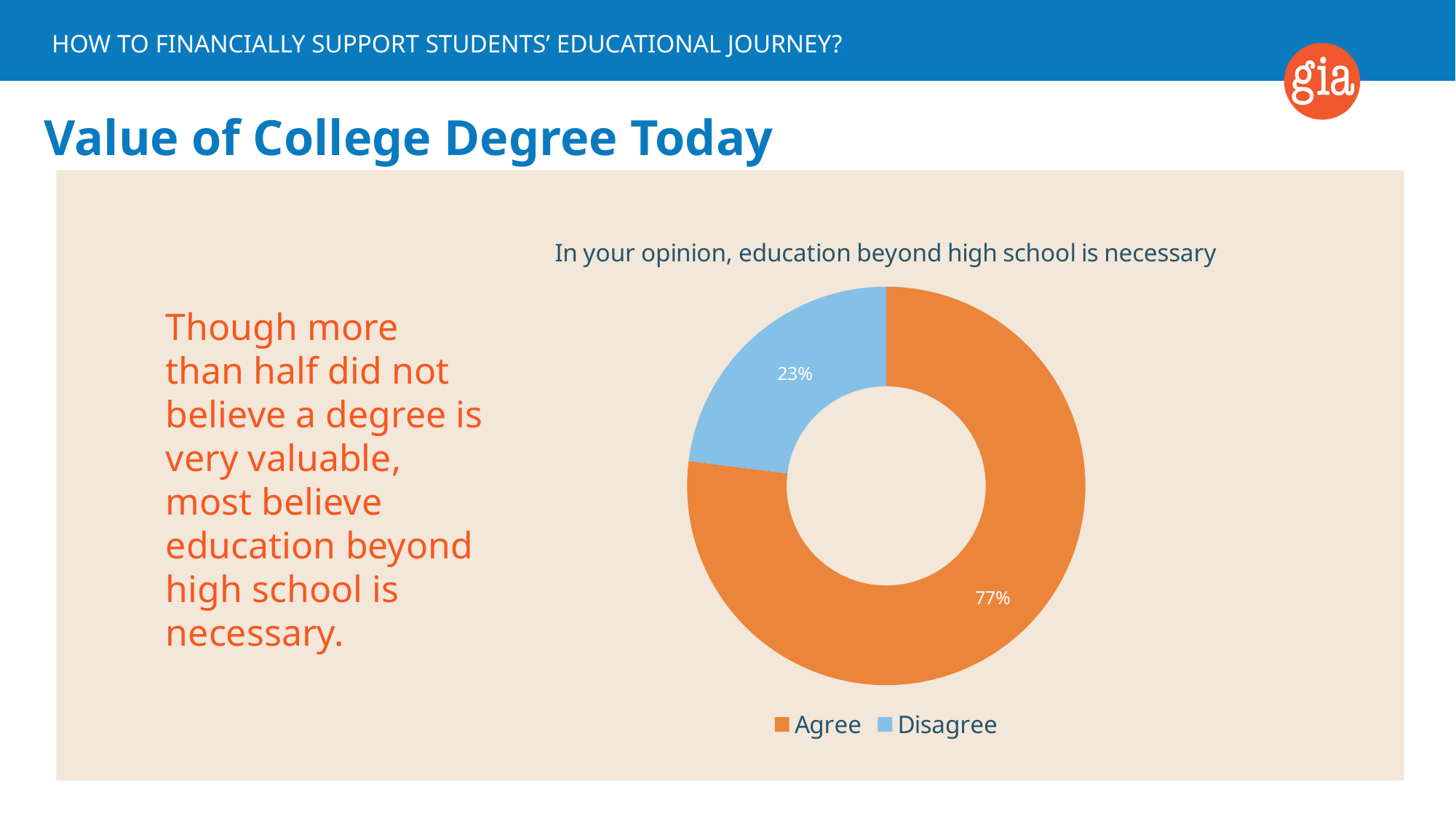
What percentage of respondents agree that education beyond high school is necessary? 77% What is the total of the two percentages shown in the chart? 100% What is the difference in percentage points between Agree and Disagree? 54 What is the title of the chart? In your opinion, education beyond high school is necessary What kind of chart is shown on the slide? Doughnut chart Which is larger, the share for Agree or the share for Disagree? Agree Which response has the smallest share of the chart? Disagree What colour represents Disagree in the chart? Light blue What percentage of respondents disagree that education beyond high school is necessary? 23% How many entries does the legend list? 2 How many categories are shown in the chart? 2 Which response has the largest share of the chart? Agree